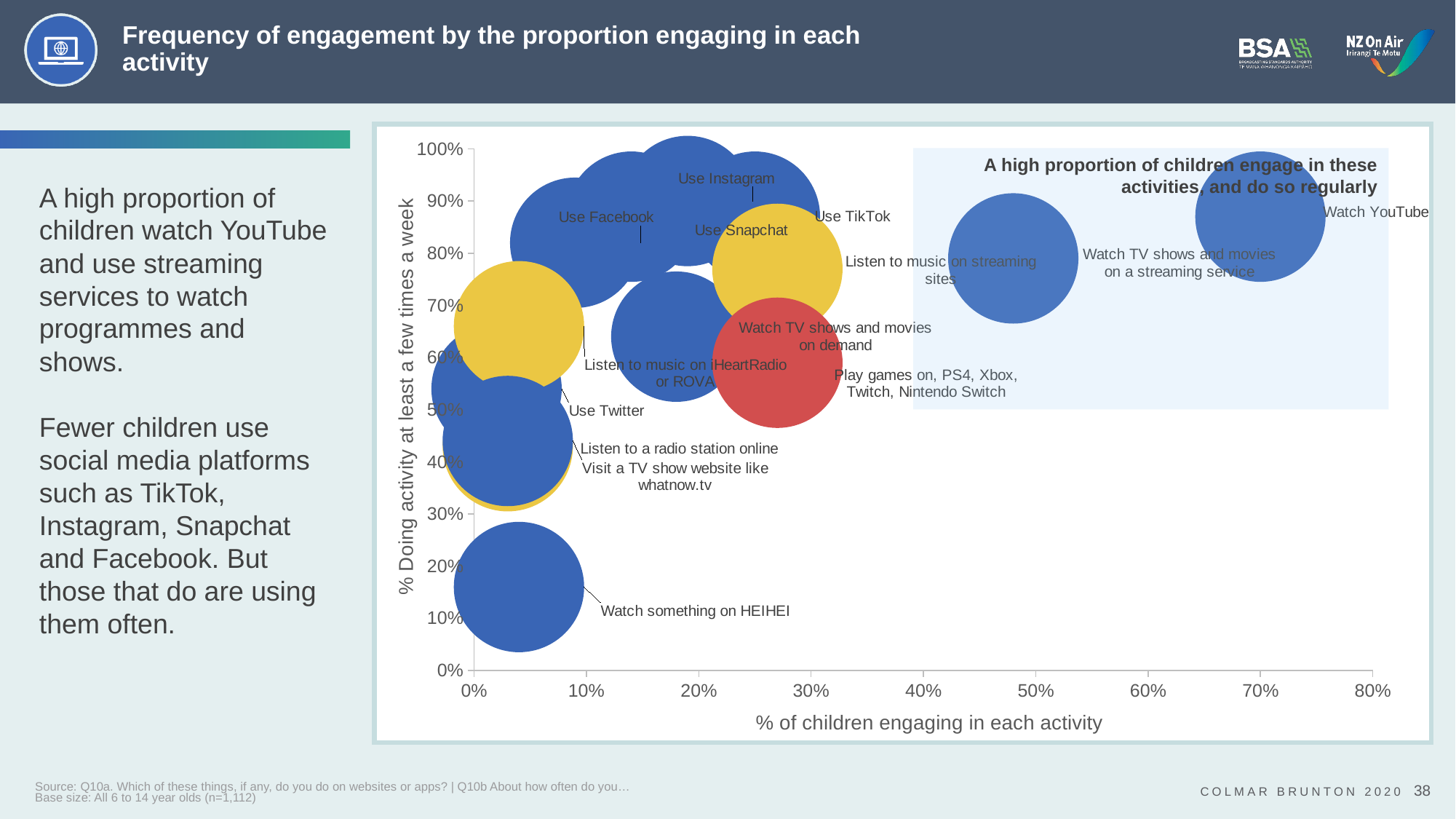
Which has a higher % doing the activity at least a few times a week: 'Use Instagram' or 'Watch something on HEIHEI'? Use Instagram Is the % of children engaging in 'Use Facebook' greater or less than 20%? less Is the % of children engaging in 'Watch TV shows and movies on a streaming service' greater or less than 40%? greater Which has a higher % of children engaging: 'Watch YouTube' or 'Watch something on HEIHEI'? Watch YouTube What kind of chart is shown on the slide? bubble chart What is the title of the x axis? % of children engaging in each activity Is the % doing 'Watch something on HEIHEI' at least a few times a week greater or less than 30%? less Which activity has the highest % of children engaging in it? Watch YouTube What is the title of the y axis? % Doing activity at least a few times a week Which activity has the lowest % doing the activity at least a few times a week? Watch something on HEIHEI